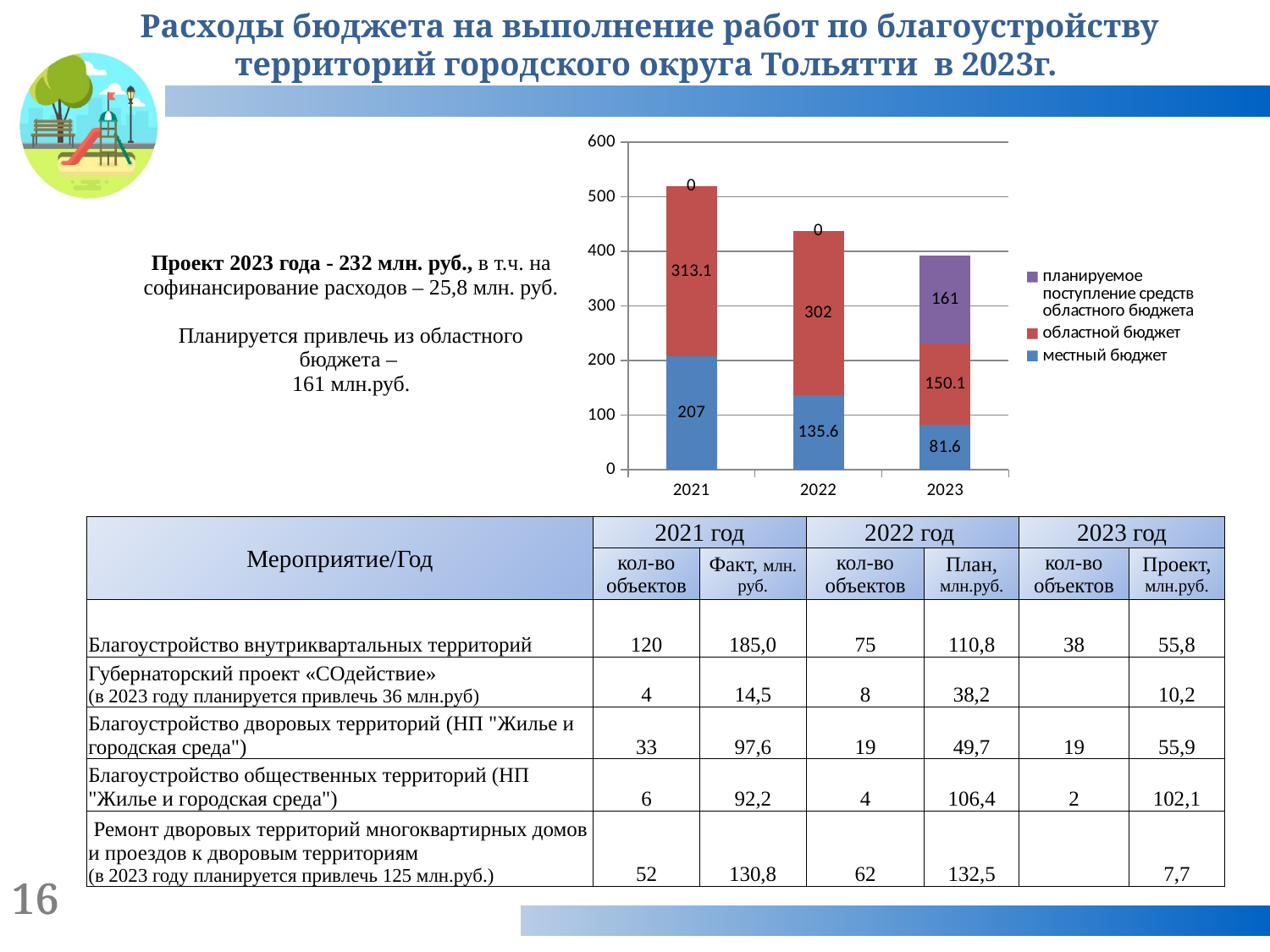
What is the total of the stacked bar for 2023? 392.7 Which year has the lowest value for областной бюджет? 2023 What is the value of областной бюджет for 2022? 302 Which year has the highest value for местный бюджет? 2021 How many years are shown on the x axis of the chart? 3 Does the value of местный бюджет rise or fall from 2021 to 2023? fall What type of chart is shown on the slide? stacked bar chart What is the value of планируемое поступление средств областного бюджета for 2023? 161 What is the value of местный бюджет for 2021? 207 What is the difference between the местный бюджет values for 2021 and 2022? 71.4 How many series does the chart legend list? 3 What is the value of местный бюджет for 2023? 81.6